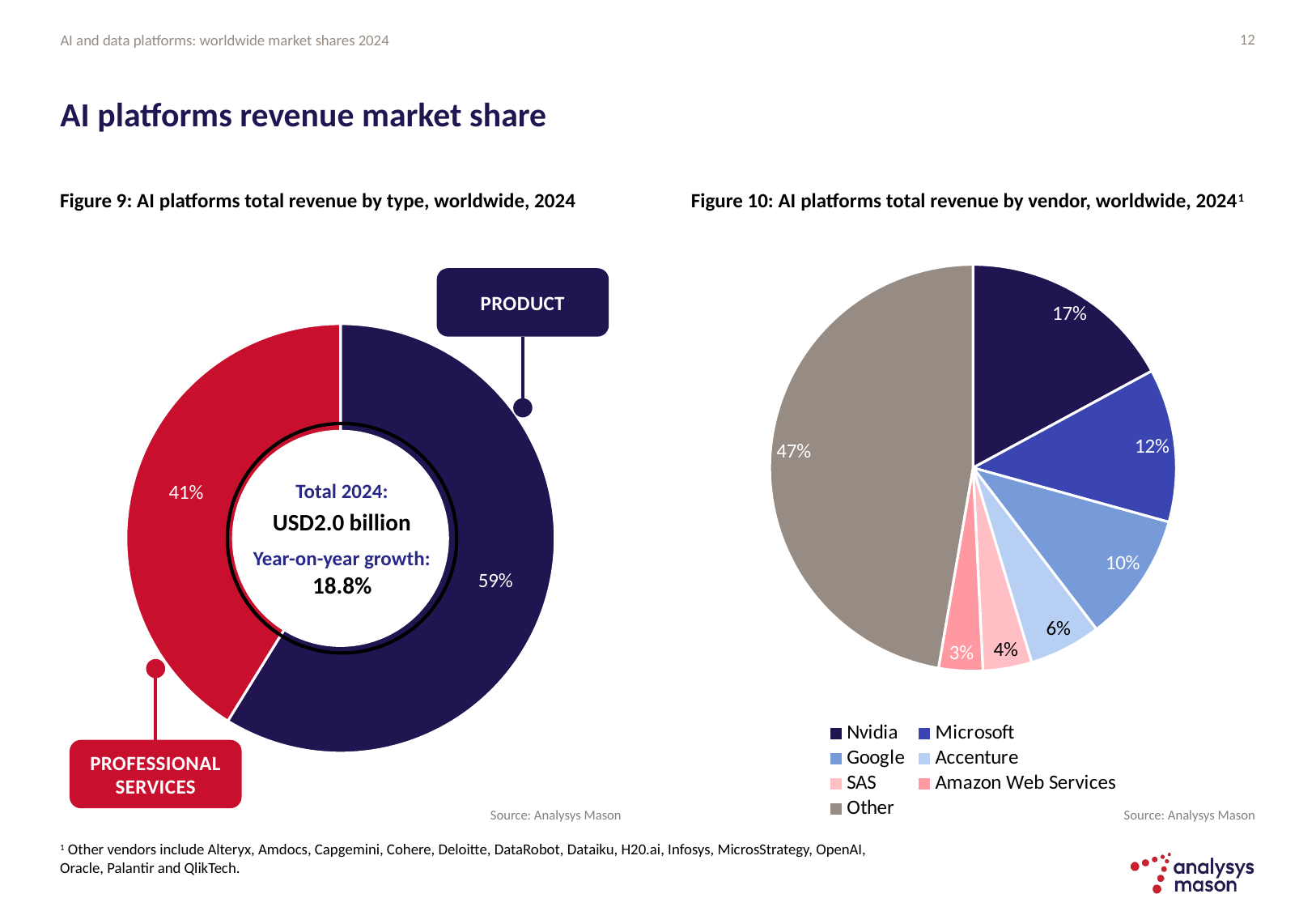
In Figure 10, what share of AI platforms revenue does Microsoft hold? 12% In Figure 10, which named vendor has the smallest share? Amazon Web Services What type of chart is Figure 10? Pie chart In Figure 9, what is the total 2024 AI platforms revenue shown in the centre of the chart? USD2.0 billion In Figure 9, what is the difference in percentage points between the Product and Professional Services shares? 18 percentage points In Figure 9, what share of AI platforms total revenue comes from Professional Services? 41% In Figure 9, which revenue type has the larger share, Product or Professional Services? Product In Figure 9, what share of AI platforms total revenue comes from Product? 59% In Figure 10, how many vendor categories does the legend list? 7 In Figure 10, which vendor category has the largest share? Other In Figure 10, what share of AI platforms revenue does Nvidia hold? 17% In Figure 10, what share of AI platforms revenue does Google hold? 10%